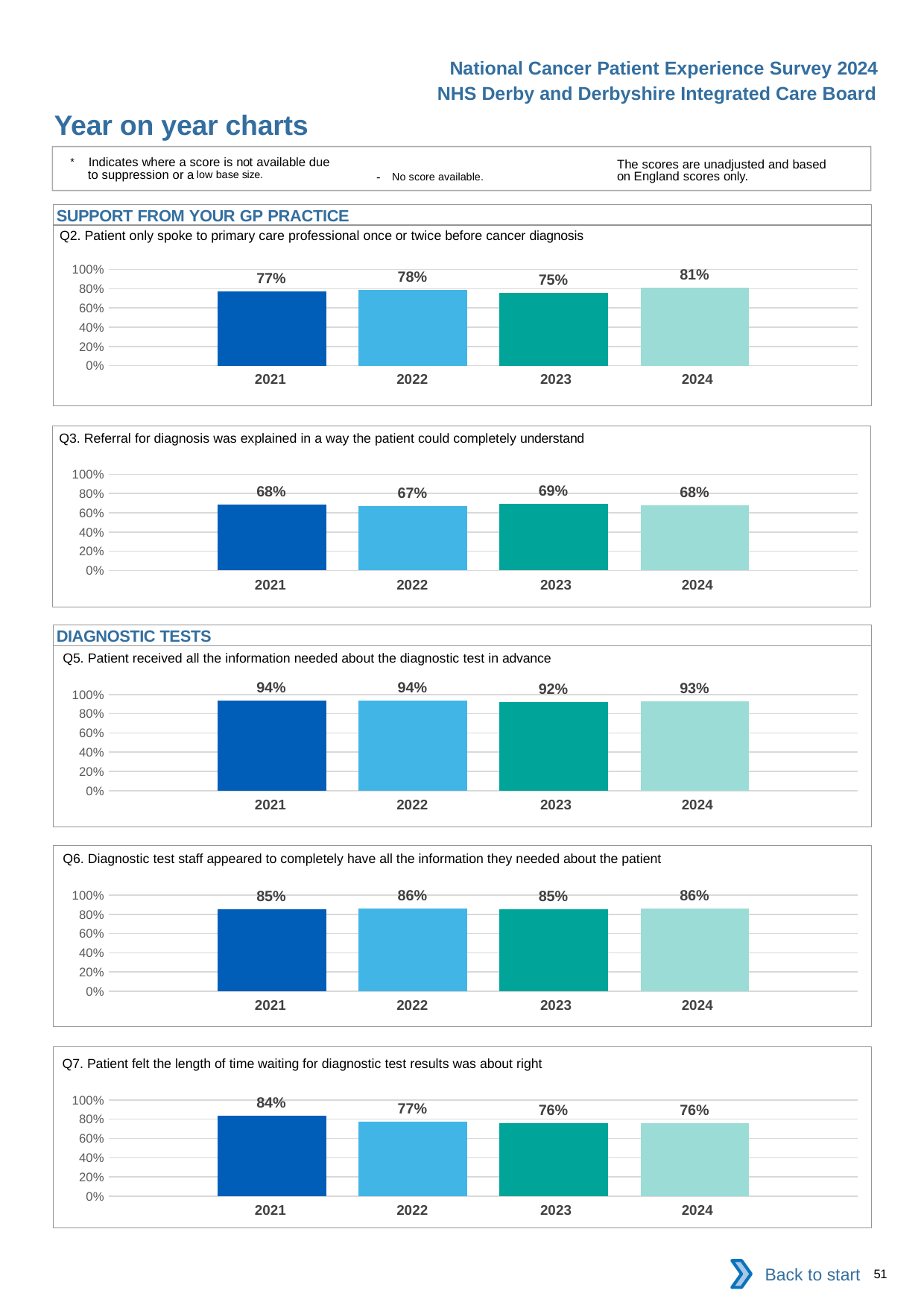
In the Q5 chart (patient received all the information needed about the diagnostic test in advance), what is the difference between the 2021 and 2023 values? 2 percentage points How many years are shown on the x axis of the Q2 chart? 4 In the Q3 chart, which year has the highest value? 2023 In the Q6 chart (diagnostic test staff appeared to completely have all the information they needed about the patient), what is the value for 2022? 86% What type of chart is used for Q6? Bar chart In the Q7 chart (patient felt the length of time waiting for diagnostic test results was about right), which year has the highest value? 2021 In the Q7 chart, what is the difference between the 2021 and 2022 values? 7 percentage points In the Q7 chart, is the value for 2021 greater or less than 80%? greater In the Q2 chart (patient only spoke to primary care professional once or twice before cancer diagnosis), what is the value for 2024? 81% In the Q2 chart, which year has the lowest value? 2023 In the Q3 chart (referral for diagnosis was explained in a way the patient could completely understand), what is the value for 2022? 67% In the Q5 chart, what is the value for 2024? 93%